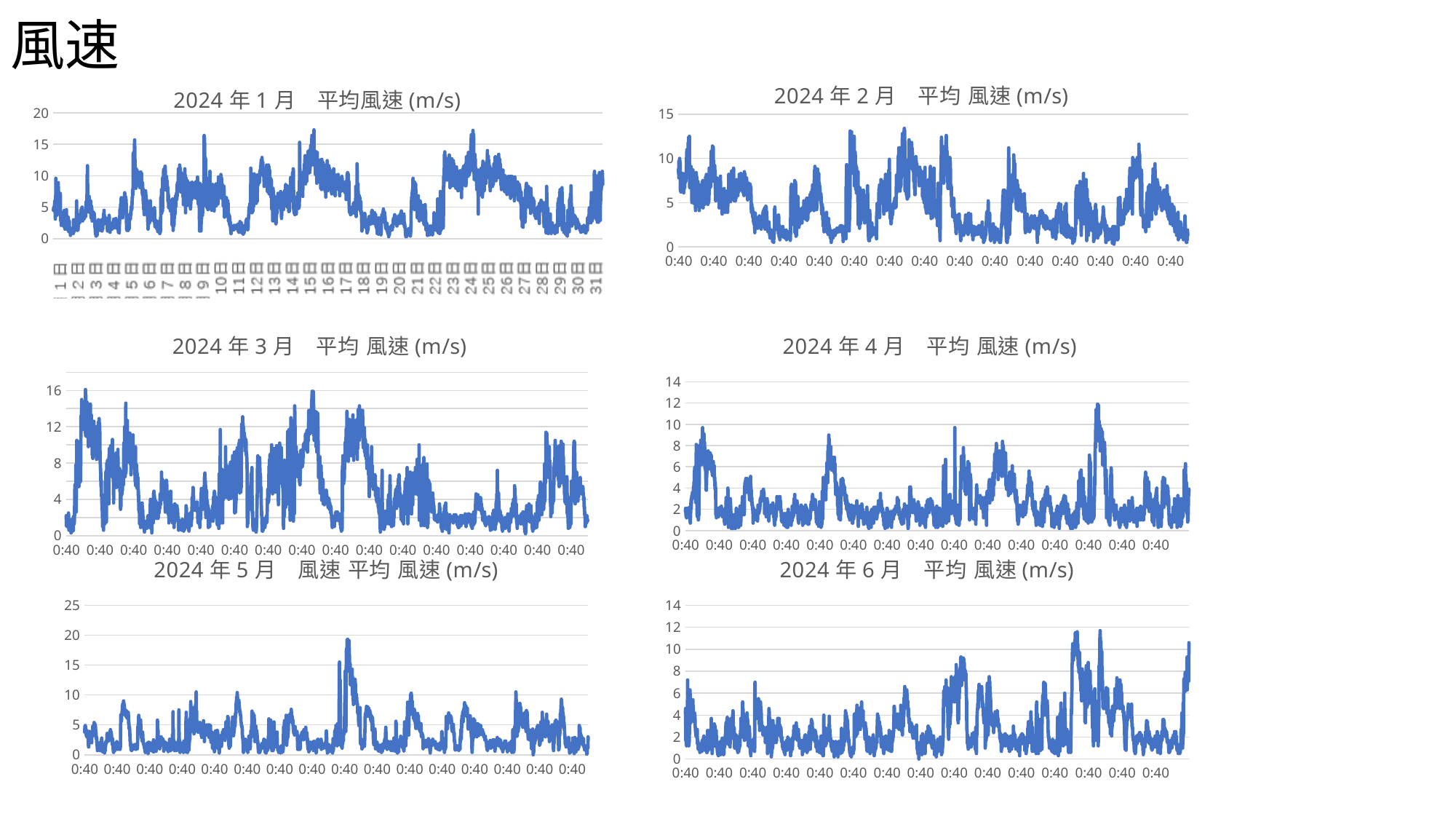
What kind of chart is the "2024 年 1 月 平均風速 (m/s)" chart? line chart In the "2024 年 1 月 平均風速 (m/s)" chart, is the highest value reached greater or less than 15? greater In the "2024 年 6 月 平均 風速 (m/s)" chart, is the highest value reached greater or less than 10? greater In the "2024 年 4 月 平均 風速 (m/s)" chart, is the highest value reached greater or less than 10? greater How many charts are shown on the slide? 6 In the "2024 年 1 月 平均風速 (m/s)" chart, how many day labels are shown on the x axis? 31 Which chart reaches a higher peak wind speed, the "2024 年 5 月" chart or the "2024 年 6 月" chart? 2024 年 5 月 What is the highest value shown on the vertical axis of the "2024 年 5 月 風速 平均 風速 (m/s)" chart? 25 What unit of wind speed is given in the chart titles? m/s